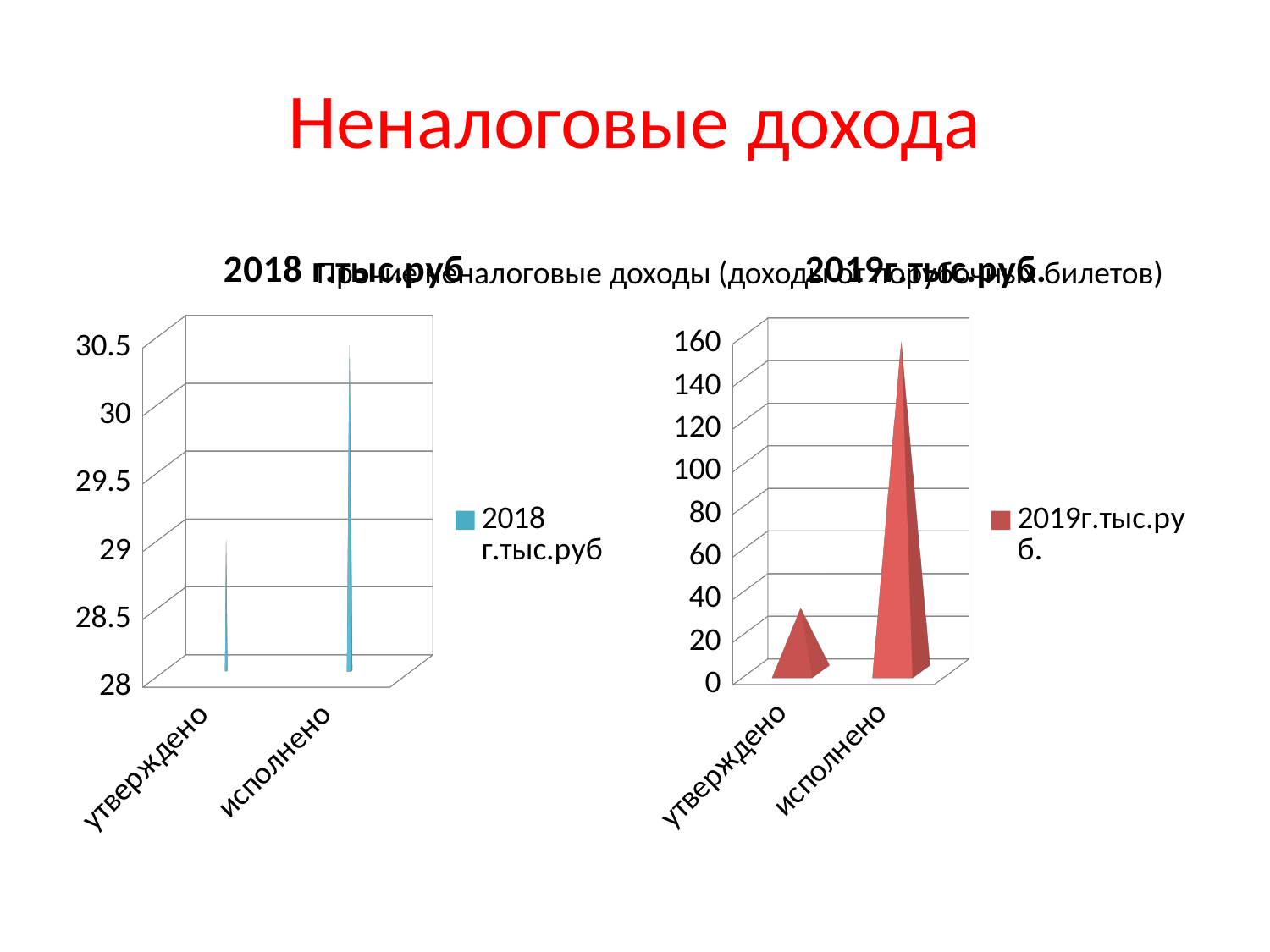
What is the legend entry of the right chart? 2019г.тыс.руб. On the right chart, is the value for утверждено greater or less than 40? less On the left chart, which category has the higher value, утверждено or исполнено? исполнено On the right chart, do the values rise or fall from утверждено to исполнено? rise On the right chart, is the value for исполнено greater or less than 140? greater How many series does the legend of the left chart list? 1 On the left chart, is the value for утверждено greater or less than 29.5? less On the right chart, which category has the highest value? исполнено On the right chart, which category has the lowest value? утверждено What kind of chart is the right chart? bar chart How many categories are shown on the x axis of the right chart? 2